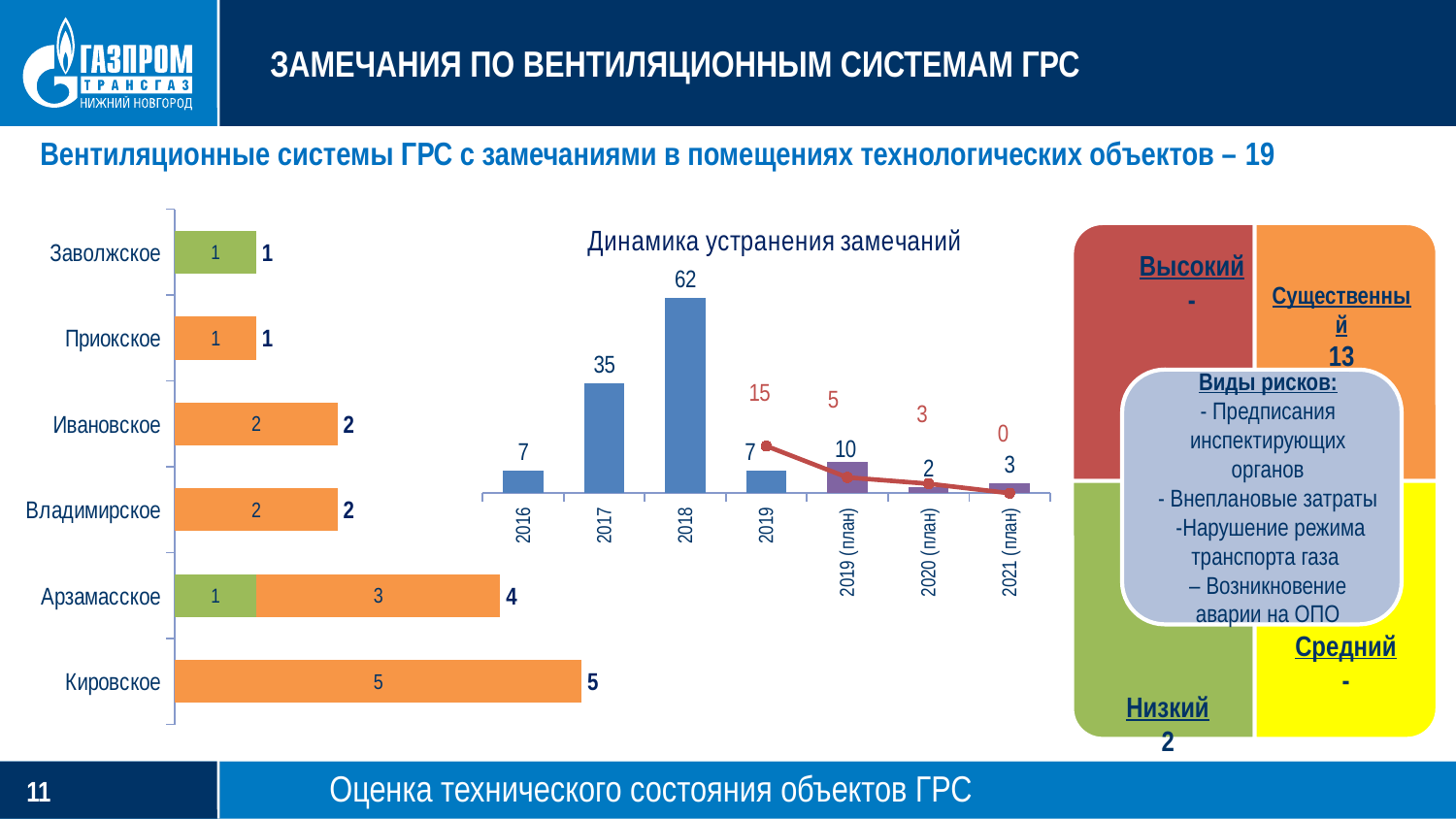
In the horizontal bar chart on the left, which category has the highest total? Кировское In the chart titled 'Динамика устранения замечаний', what is the line value for 2021 (план)? 0 In the horizontal bar chart on the left, what is the total for Арзамасское? 4 In the chart titled 'Динамика устранения замечаний', what is the bar value for 2019 (план)? 10 In the horizontal bar chart on the left, how many categories are shown? 6 In the chart titled 'Динамика устранения замечаний', what is the bar value for 2018? 62 In the horizontal bar chart on the left, what is the difference between the totals for Кировское and Ивановское? 3 What kind of chart is the chart on the left of the slide? Bar chart In the chart titled 'Динамика устранения замечаний', which year has the highest bar value? 2018 In the chart titled 'Динамика устранения замечаний', what is the bar value for 2017? 35 In the chart titled 'Динамика устранения замечаний', what is the difference between the bar values for 2018 and 2017? 27 In the chart titled 'Динамика устранения замечаний', how many categories are shown on the x axis? 7